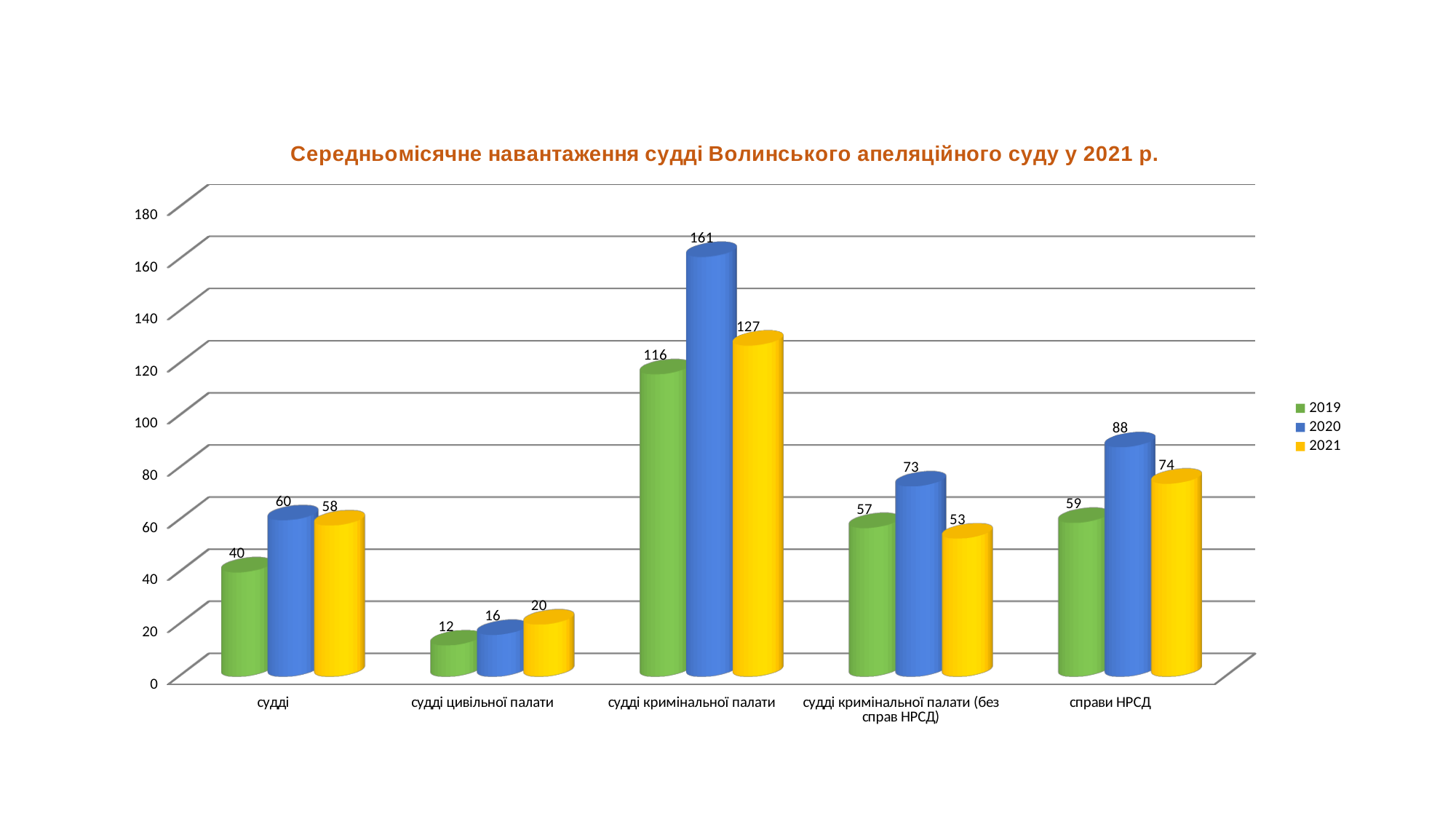
What kind of chart is shown on the slide? bar chart Which category has the lowest value for the 2021 series? судді цивільної палати Which is larger in the category "справи НРСД": the 2020 value or the 2019 value? 2020 How many categories are shown on the x axis? 5 How many series does the legend list? 3 What is the difference between the 2020 and 2021 values in the category "судді кримінальної палати"? 34 What is the value for 2021 in the category "судді кримінальної палати (без справ НРСД)"? 53 What is the value for 2021 in the category "справи НРСД"? 74 Which category has the highest value for the 2019 series? судді кримінальної палати What is the value for 2020 in the category "судді кримінальної палати"? 161 What is the value for 2019 in the category "судді"? 40 Which colour represents the 2021 series in the legend? yellow